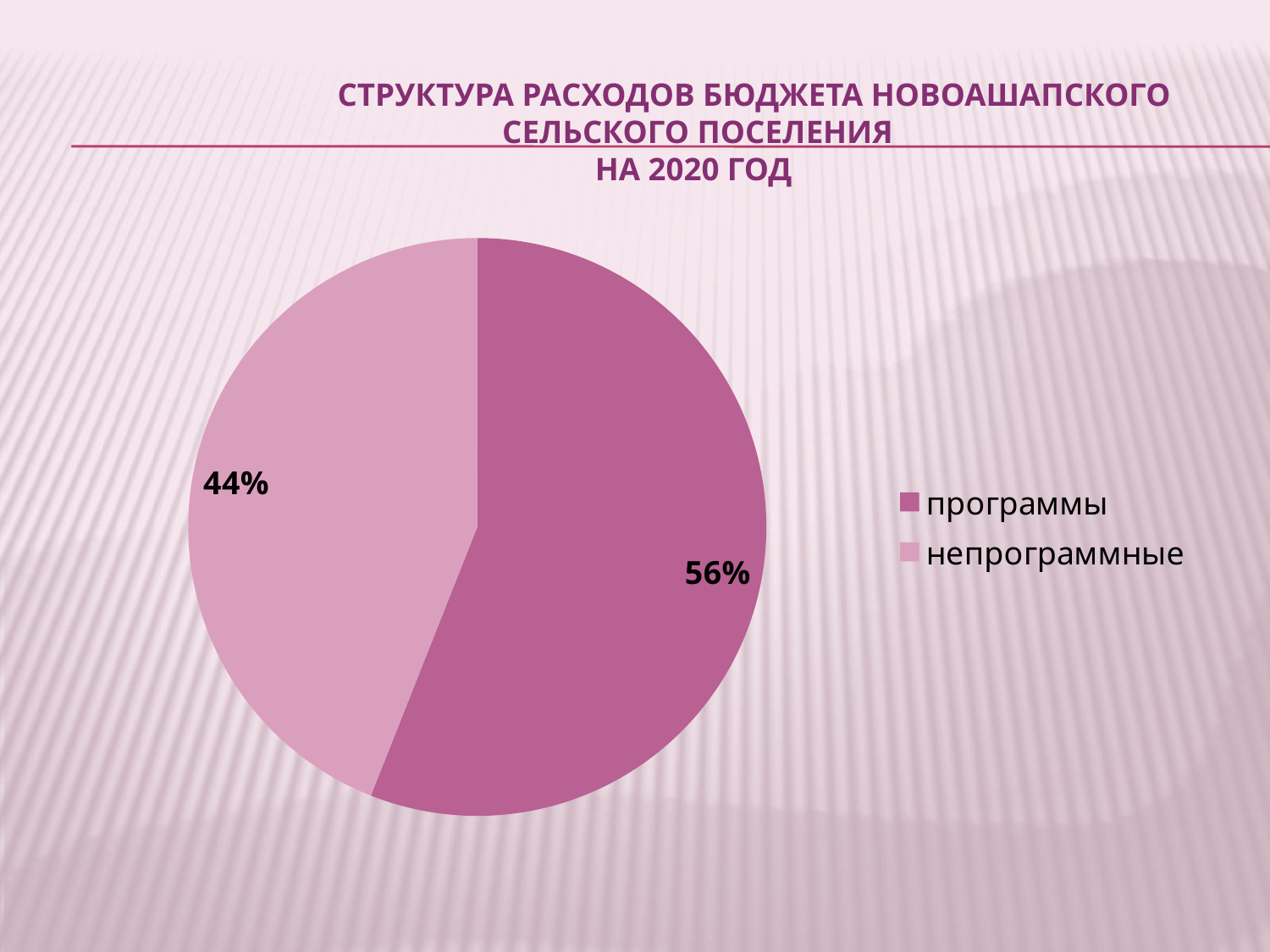
Is the share for "программы" greater or less than 50%? greater How many slices does the pie chart have? 2 Which is larger, the "программы" slice or the "непрограммные" slice? программы What share of the pie does the "непрограммные" slice represent? 44% What kind of chart is shown on the slide? pie chart What share of the pie does the "программы" slice represent? 56% Which legend entry is shown in the lighter pink colour? непрограммные How many entries does the legend list? 2 What is the difference in percentage points between the "программы" and "непрограммные" slices? 12% What is the title of the chart on the slide? Структура расходов бюджета Новоашапского сельского поселения на 2020 год Which slice is the largest in the pie chart? программы Which slice is the smallest in the pie chart? непрограммные